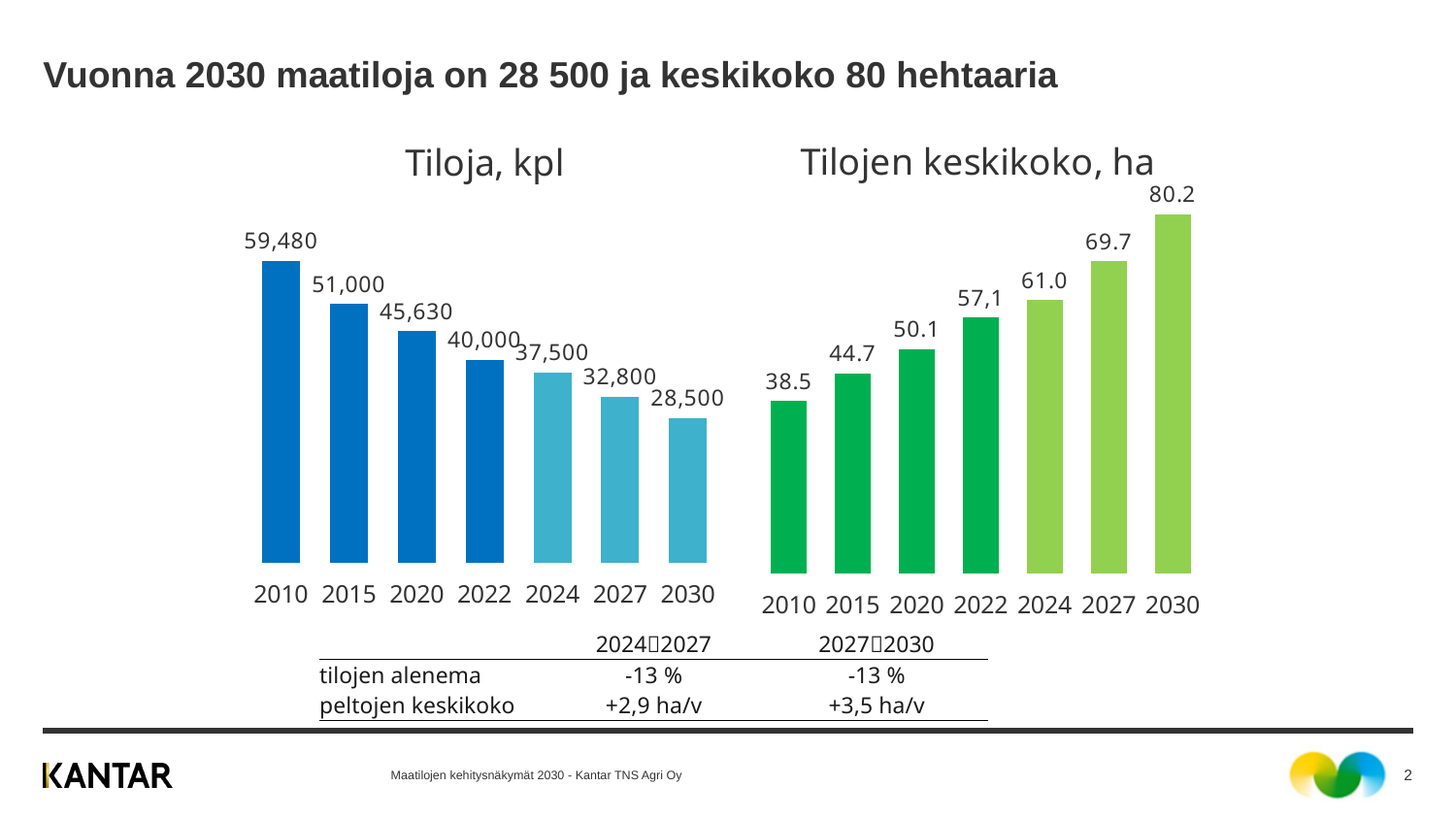
In the 'Tilojen keskikoko, ha' chart, what is the value for 2027? 69.7 In the 'Tilojen keskikoko, ha' chart, what is the difference between the values for 2030 and 2027? 10.5 In the 'Tiloja, kpl' chart, which is larger, the value for 2020 or the value for 2024? 2020 How many years are shown on the x axis of the 'Tilojen keskikoko, ha' chart? 7 In the 'Tiloja, kpl' chart, what is the value for 2030? 28,500 In the 'Tilojen keskikoko, ha' chart, do the values rise or fall from 2010 to 2030? Rise In the 'Tiloja, kpl' chart, what is the difference between the values for 2010 and 2015? 8,480 In the 'Tilojen keskikoko, ha' chart, what is the value for 2010? 38.5 In the 'Tilojen keskikoko, ha' chart, which year has the highest value? 2030 In the 'Tiloja, kpl' chart, which year has the lowest value? 2030 In the 'Tiloja, kpl' chart, what is the value for 2010? 59,480 What kind of chart is the 'Tiloja, kpl' chart? Bar chart